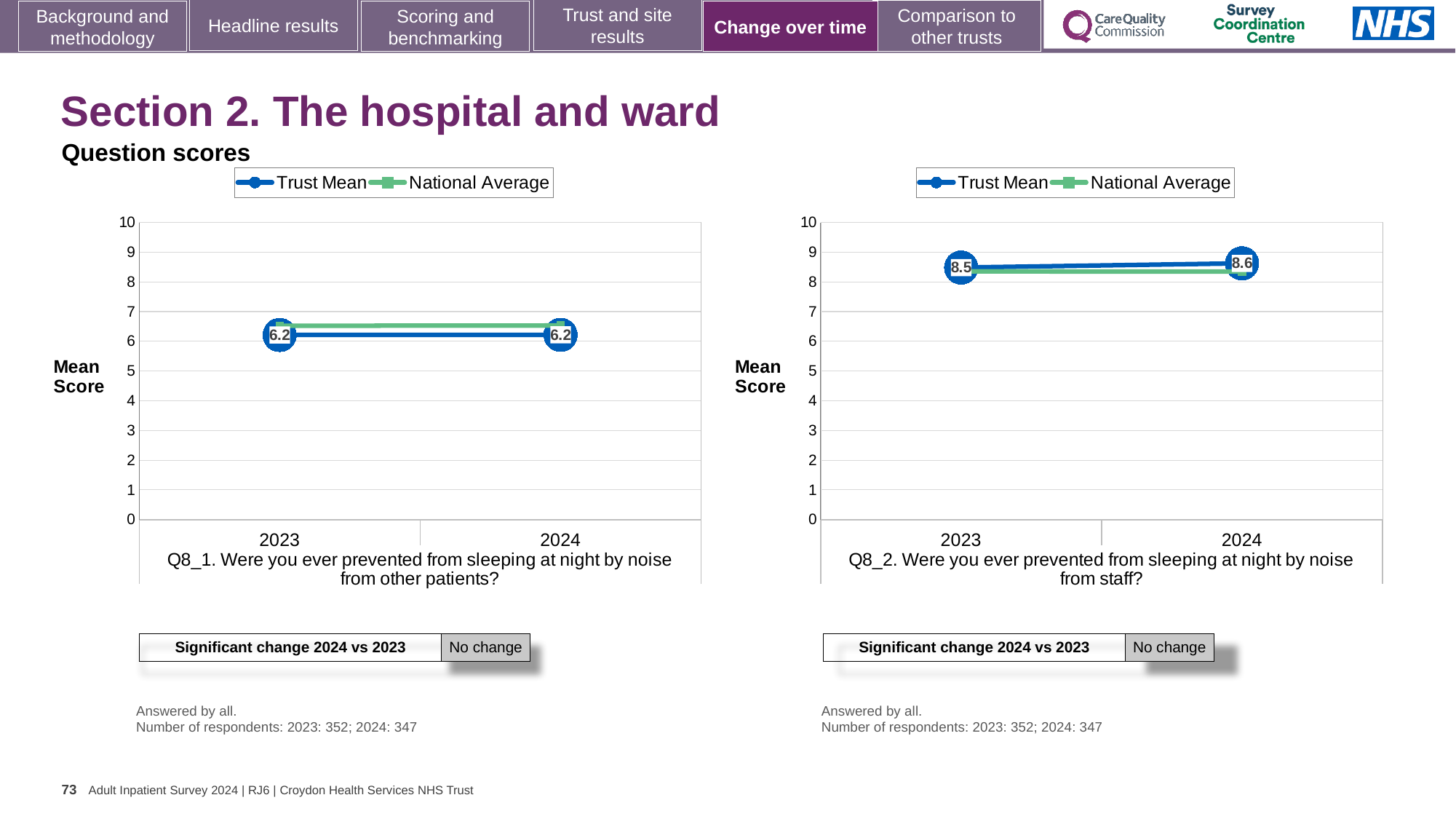
In the right chart (Q8_2), what is the Trust Mean score for 2024? 8.6 In the left chart (Q8_1), which is higher in 2024, the Trust Mean or the National Average? National Average In the left chart (Q8_1), is the National Average for 2023 greater or less than 6? greater What kind of chart is used for Q8_1? line chart In the right chart (Q8_2), does the Trust Mean rise, fall or stay the same from 2023 to 2024? rise In the right chart (Q8_2), what is the Trust Mean score for 2023? 8.5 In the left chart (Q8_1), what is the Trust Mean score for 2024? 6.2 In the right chart (Q8_2), what is the difference between the Trust Mean scores for 2024 and 2023? 0.1 How many series does the legend of the right chart (Q8_2) list? 2 In the left chart (Q8_1), what is the Trust Mean score for 2023? 6.2 How many years are plotted on the x axis of the left chart (Q8_1)? 2 In the left chart (Q8_1), does the Trust Mean rise, fall or stay the same from 2023 to 2024? stay the same